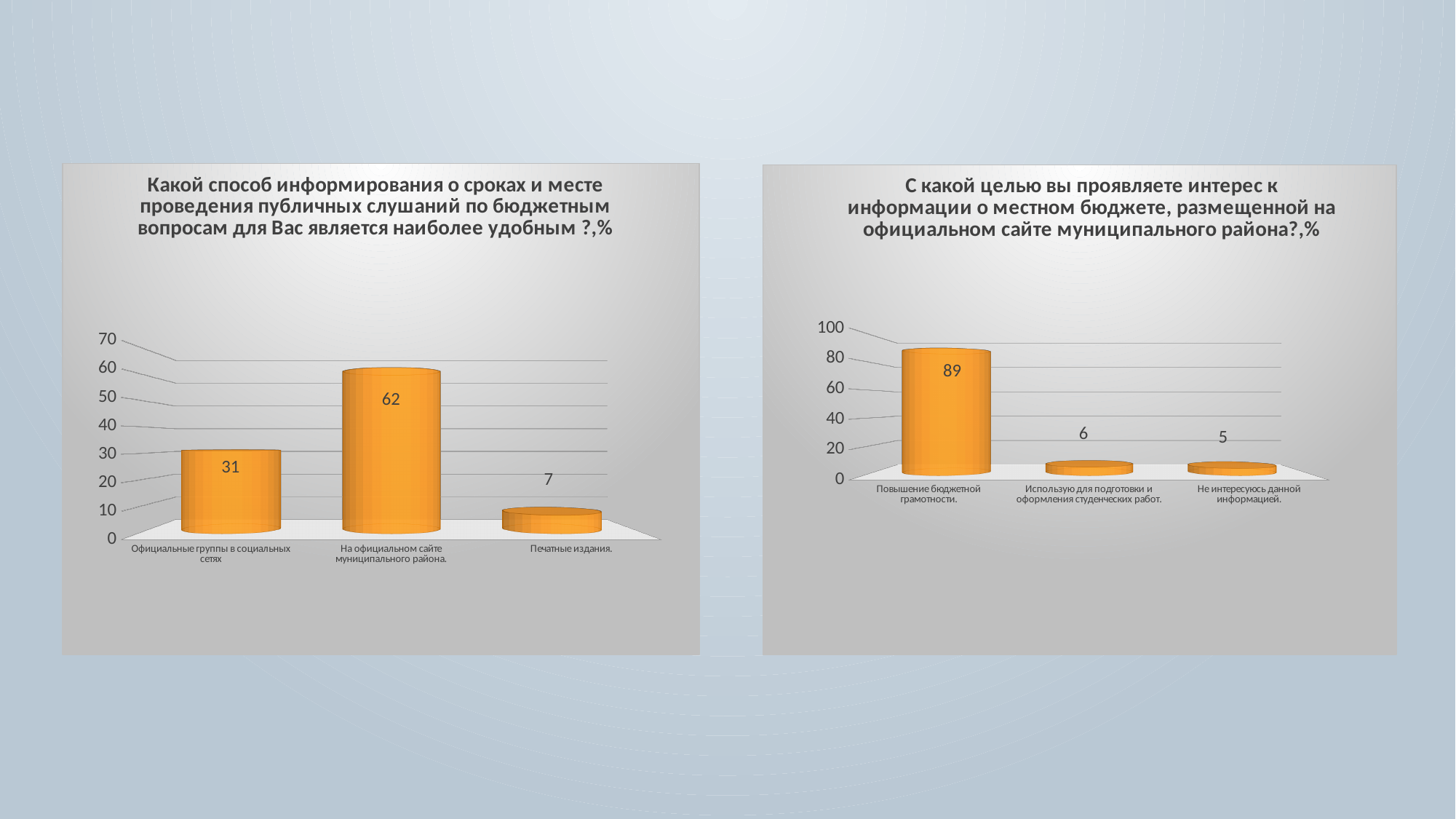
In the left chart, how many categories are shown? 3 In the right chart, what is the value for 'Повышение бюджетной грамотности'? 89 In the left chart, is the value for 'Официальные группы в социальных сетях' greater or less than 40? less In the right chart, what is the difference between 'Повышение бюджетной грамотности' and 'Использую для подготовки и оформления студенческих работ'? 83 In the right chart, which is larger: 'Использую для подготовки и оформления студенческих работ' or 'Не интересуюсь данной информацией'? Использую для подготовки и оформления студенческих работ In the left chart, which category has the highest value? На официальном сайте муниципального района In the left chart, what is the value for 'Печатные издания'? 7 What type of chart is the right chart? bar chart In the right chart, which category has the lowest value? Не интересуюсь данной информацией In the left chart, what is the value for 'На официальном сайте муниципального района'? 62 In the left chart, what is the difference between 'На официальном сайте муниципального района' and 'Официальные группы в социальных сетях'? 31 In the right chart, what is the value for 'Не интересуюсь данной информацией'? 5